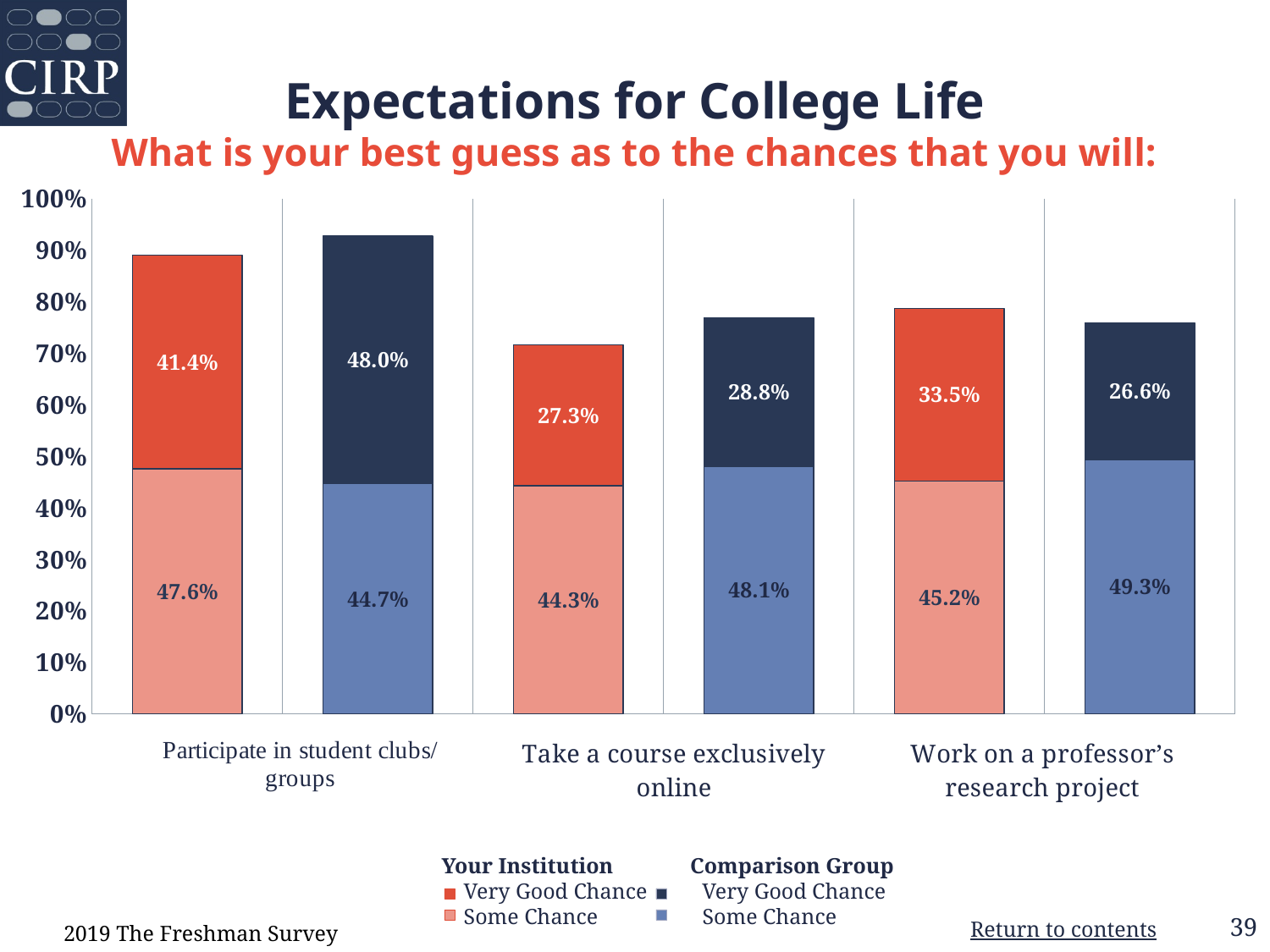
What is the total of the stacked bar for Your Institution for 'Take a course exclusively online'? 71.6% Which category has the lowest 'Very Good Chance' value for the Comparison Group? Work on a professor's research project For 'Work on a professor's research project', which is larger: Your Institution's 'Very Good Chance' value or the Comparison Group's 'Very Good Chance' value? Your Institution How many series does the legend list? 4 What is the total of the stacked bar for the Comparison Group for 'Participate in student clubs/groups'? 92.7% Which category has the highest 'Very Good Chance' value for Your Institution? Participate in student clubs/groups What is the 'Very Good Chance' value for the Comparison Group for 'Work on a professor's research project'? 26.6% How many categories are shown on the x axis of the chart? 3 What is the difference between the Comparison Group's and Your Institution's 'Very Good Chance' values for 'Participate in student clubs/groups'? 6.6% What kind of chart is shown on the slide? Stacked bar chart What is the 'Some Chance' value for the Comparison Group for 'Take a course exclusively online'? 48.1% What is the 'Very Good Chance' value for Your Institution for 'Participate in student clubs/groups'? 41.4%